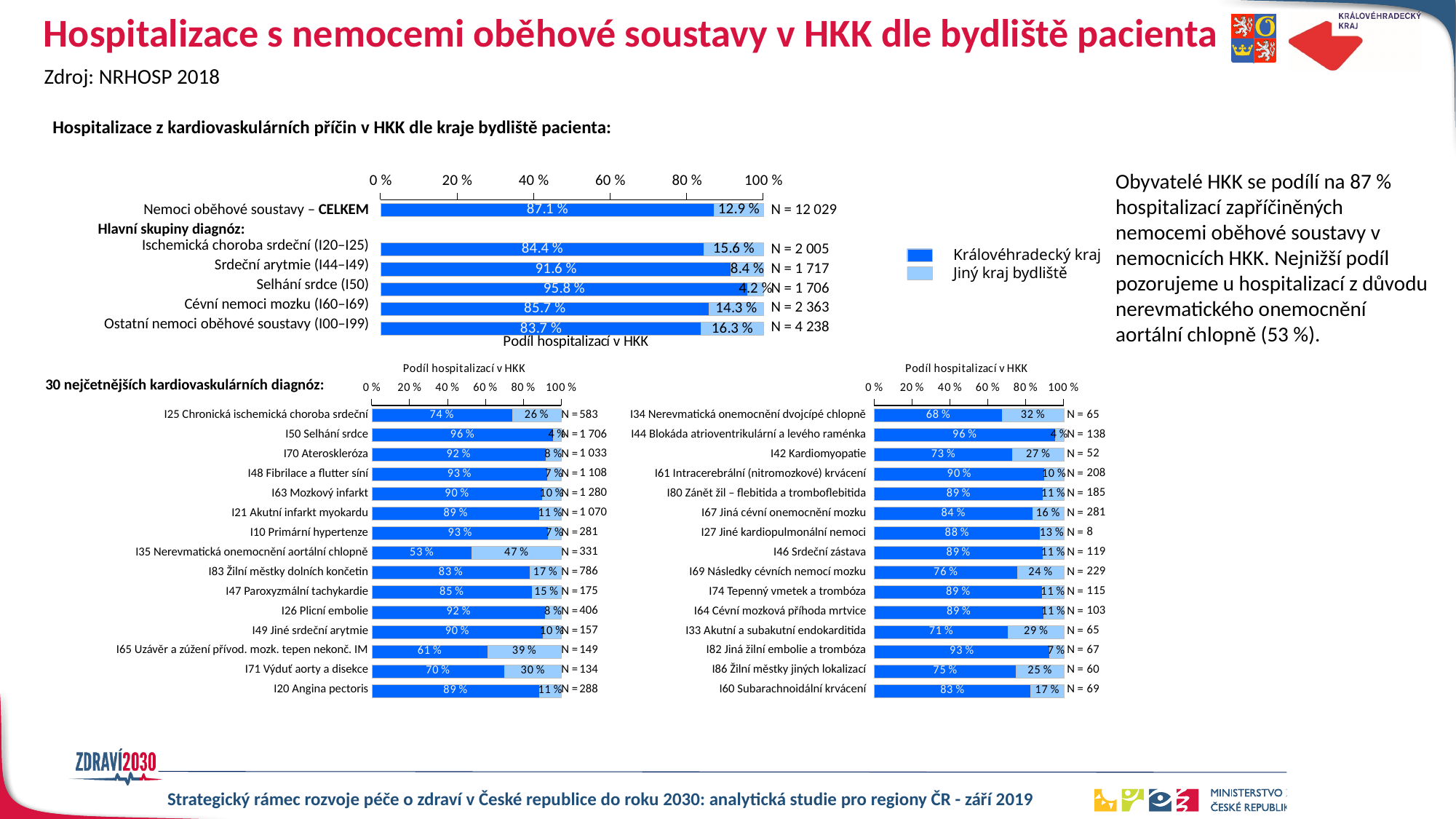
In the bottom-left chart, which diagnosis has the lowest Královéhradecký kraj share? I35 Nerevmatická onemocnění aortální chlopně In the bottom-right chart, what is the Jiný kraj bydliště share for I34 Nerevmatická onemocnění dvojcípé chlopně? 32 % In the bottom-right chart, which is larger: the Královéhradecký kraj share for I44 Blokáda atrioventrikulární a levého raménka or for I42 Kardiomyopatie? I44 Blokáda atrioventrikulární a levého raménka In the top chart, what is the difference between the Královéhradecký kraj shares for Srdeční arytmie (I44–I49) and Cévní nemoci mozku (I60–I69)? 5.9 % In the top chart (Hospitalizace z kardiovaskulárních příčin v HKK dle kraje bydliště pacienta), what is the Královéhradecký kraj share for Selhání srdce (I50)? 95.8 % In the top chart, what is the N value shown for Nemoci oběhové soustavy – CELKEM? N = 12 029 How many series does the legend of the top chart list? 2 What type of chart is used for the 30 nejčetnějších kardiovaskulárních diagnóz section? Stacked bar chart In the bottom-left chart, what is the Královéhradecký kraj share for I35 Nerevmatická onemocnění aortální chlopně? 53 % In the top chart, which main diagnosis group has the lowest Královéhradecký kraj share? Ostatní nemoci oběhové soustavy (I00–I99) In the top chart, what is the Jiný kraj bydliště share for Ischemická choroba srdeční (I20–I25)? 15.6 % In the top chart, which main diagnosis group has the highest Královéhradecký kraj share? Selhání srdce (I50)